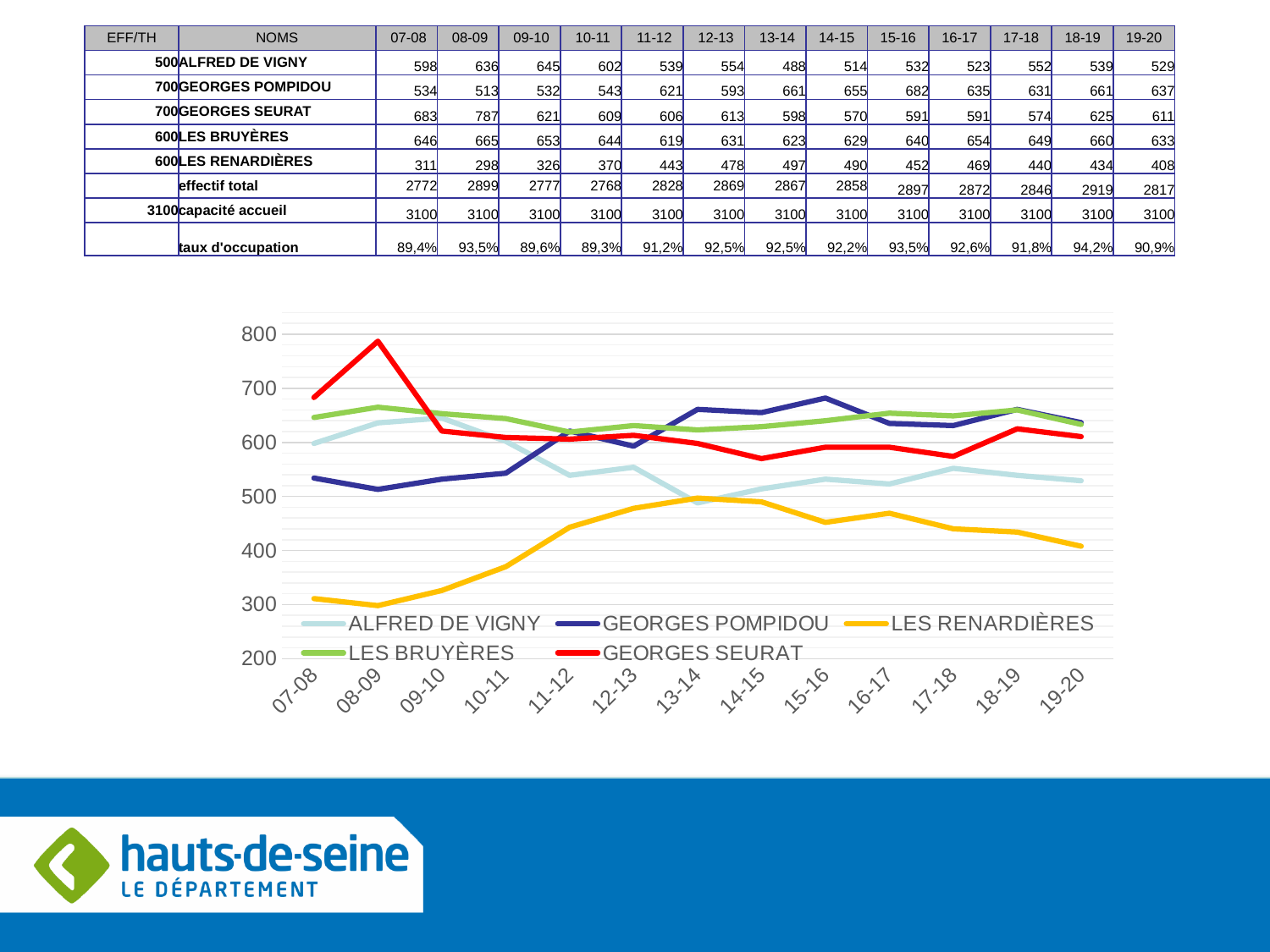
In 13-14, which is larger: GEORGES POMPIDOU or ALFRED DE VIGNY? GEORGES POMPIDOU What colour is the GEORGES SEURAT line in the chart? red What is the value for LES BRUYÈRES in 19-20? 633 What kind of chart is shown on the slide? line chart Which series has the lowest value in 07-08? LES RENARDIÈRES What is the value for GEORGES POMPIDOU in 15-16? 682 Is the value for LES RENARDIÈRES in 07-08 greater or less than 400? less How many school years are plotted along the x axis of the chart? 13 What is the difference between GEORGES SEURAT and ALFRED DE VIGNY in 08-09? 151 Does the ALFRED DE VIGNY line rise or fall overall from 07-08 to 19-20? fall How many series does the chart's legend list? 5 Which series has the highest value in 08-09? GEORGES SEURAT